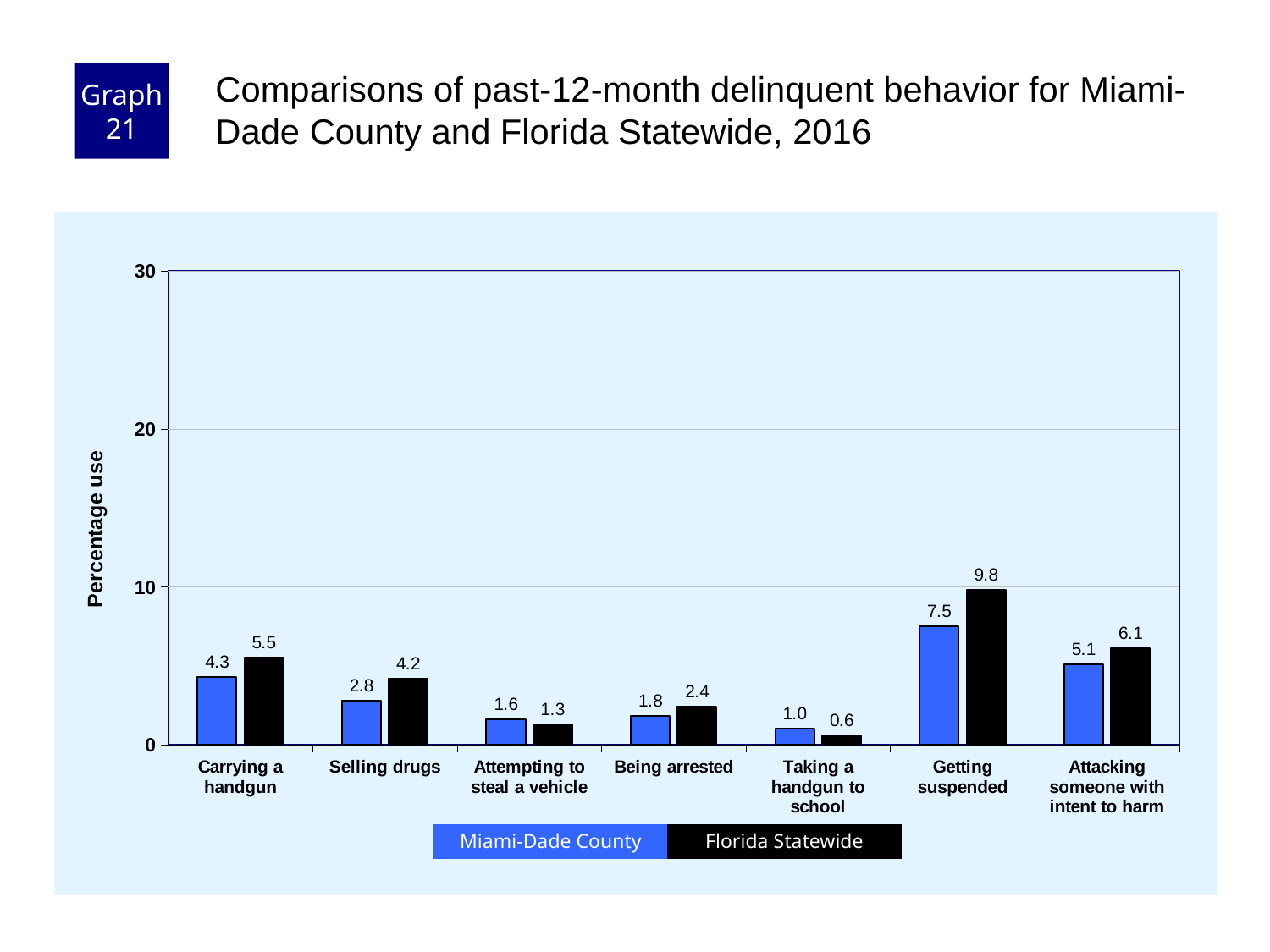
Which category has the lowest Miami-Dade County value? Taking a handgun to school Is the Florida Statewide value for Getting suspended greater or less than 10? less What is the Florida Statewide value for Selling drugs? 4.2 What is the difference between the Florida Statewide and Miami-Dade County values for Carrying a handgun? 1.2 What kind of chart is shown on the slide? bar chart What is the Miami-Dade County value for Getting suspended? 7.5 For Attempting to steal a vehicle, which is larger: the Miami-Dade County value or the Florida Statewide value? Miami-Dade County How many categories are shown on the x axis? 7 How many series does the legend list? 2 What is the difference between the Florida Statewide and Miami-Dade County values for Getting suspended? 2.3 What is the Miami-Dade County value for Taking a handgun to school? 1.0 Which category has the highest Florida Statewide value? Getting suspended